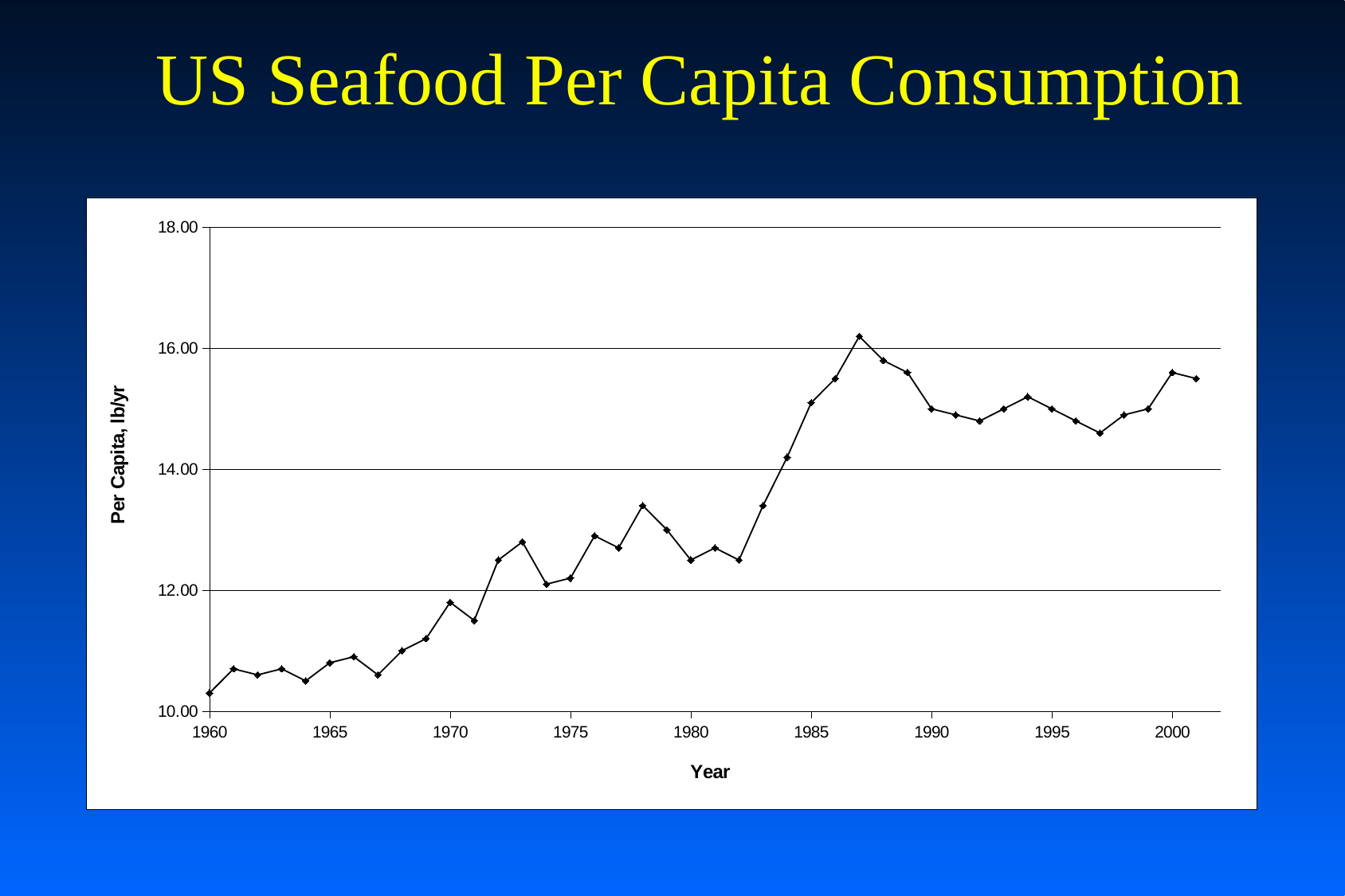
Is the value for 1960 greater or less than 12.00? less Is the value for 1987 greater or less than 16.00? greater Overall, do the values rise or fall from 1960 to 1987? rise Which year has the larger value, 1987 or 1960? 1987 What kind of chart is shown on the slide? line chart Is the value for 1997 greater or less than 16.00? less Which year has the lowest per capita seafood consumption? 1960 Which year has the larger value, 2001 or 1980? 2001 Which year has the highest per capita seafood consumption? 1987 What is the label on the y axis? Per Capita, lb/yr